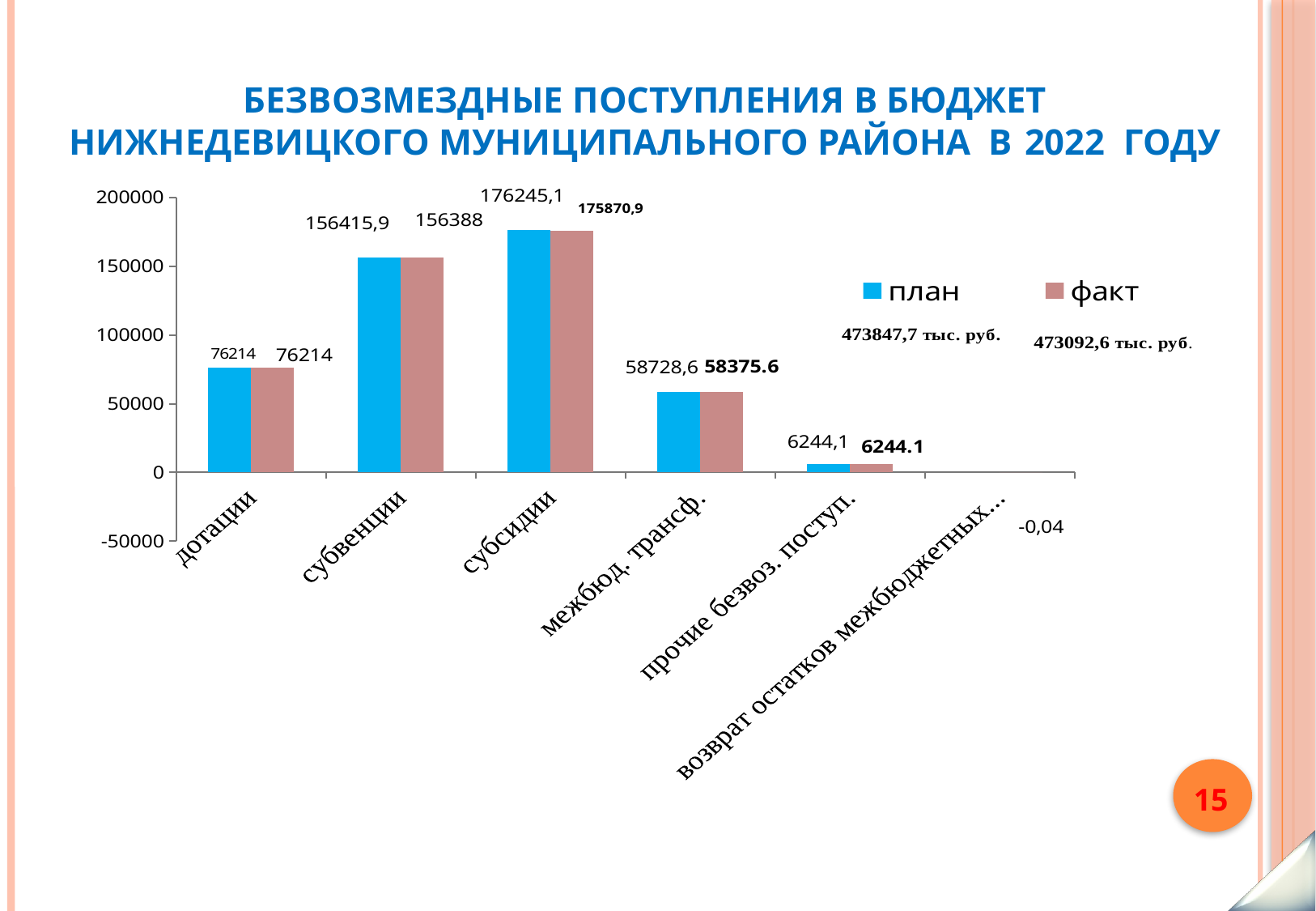
Which category has the lowest value shown on the chart? возврат остатков межбюджетных... What are the two series named in the legend? план and факт What is the план value for субсидии? 176245,1 How many series does the legend list? 2 Which is larger for субвенции, the план value or the факт value? план What is the факт value for субсидии? 175870,9 Which category has the highest план value? субсидии What total is shown next to the факт legend entry? 473092,6 тыс. руб. What is the факт value for межбюд. трансф.? 58375.6 What is the план value for дотации? 76214 What is the difference between the план and факт values for субсидии? 374,2 What type of chart is shown on the slide? bar chart